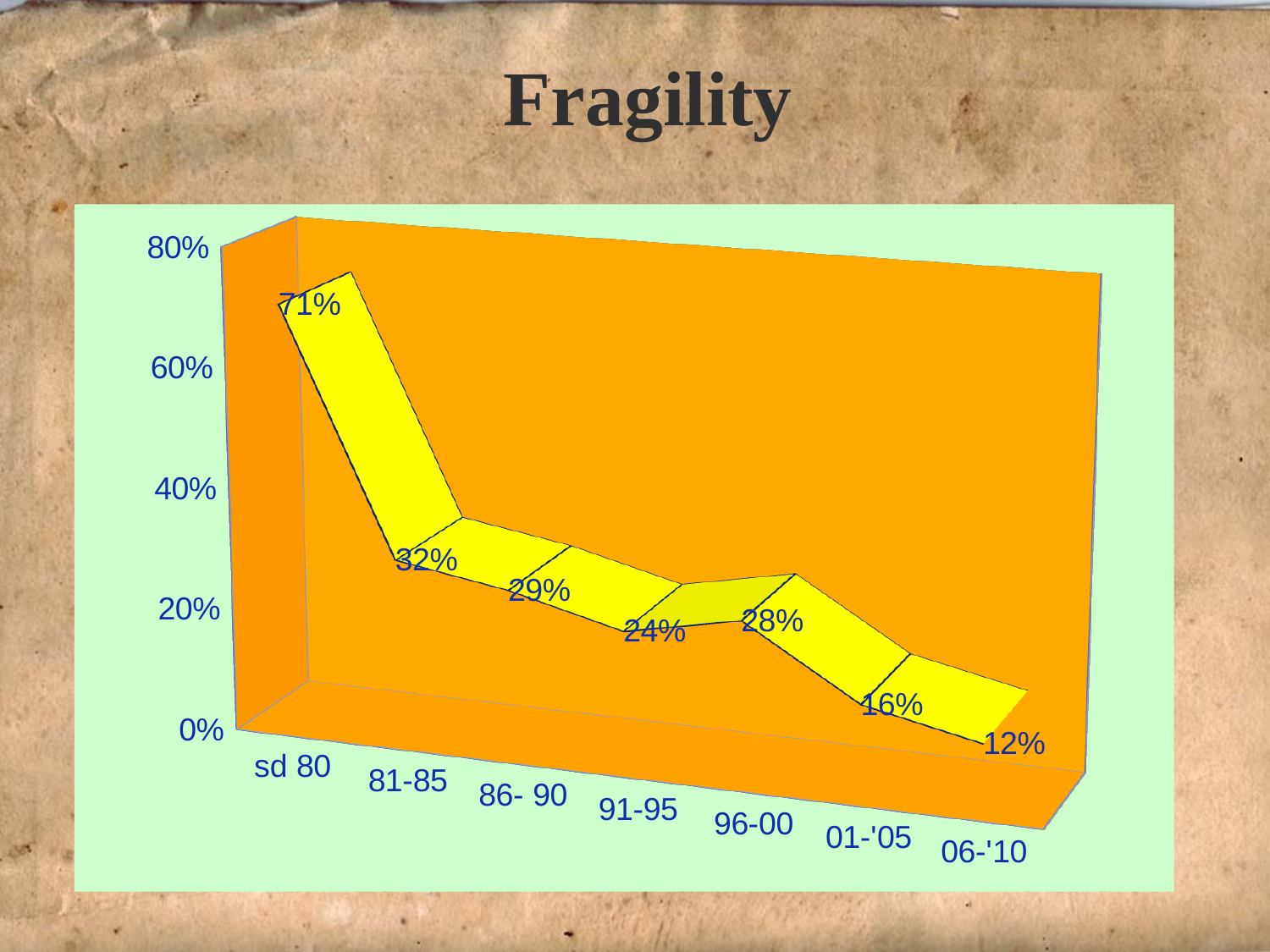
What kind of chart is this? line chart What is the value for sd 80? 71% What is the value for 91-95? 24% How many periods are shown on the x axis? 7 Which period has the highest value? sd 80 What is the value for 06-'10? 12% What is the difference between the values for 96-00 and 01-'05? 12% What is the title of the slide? Fragility Which is larger, the value for 91-95 or the value for 96-00? 96-00 What is the difference between the values for sd 80 and 81-85? 39% Which period has the lowest value? 06-'10 What is the value for 96-00? 28%